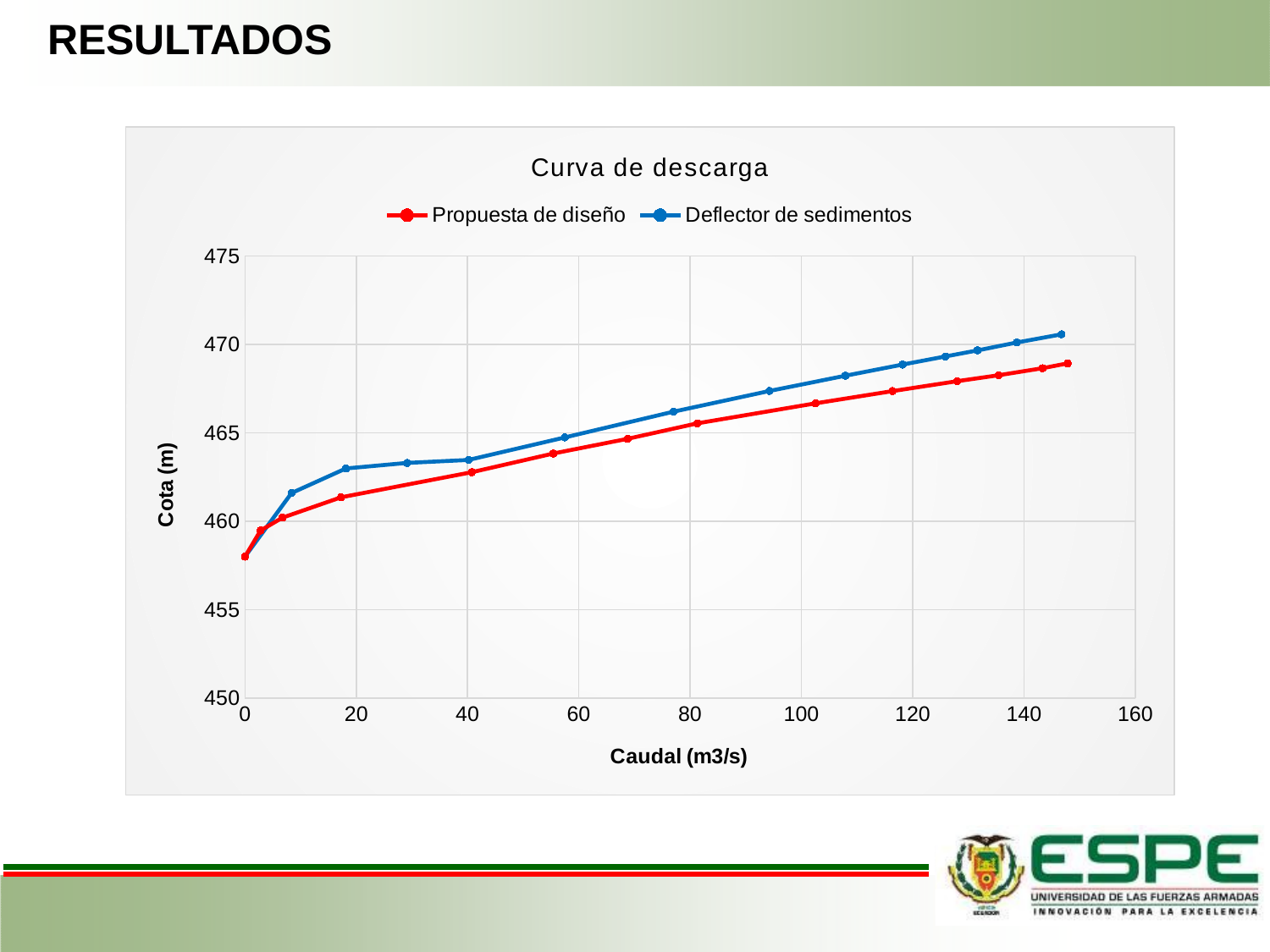
Is the value of the Deflector de sedimentos series at a Caudal of about 100 m3/s greater or less than 465? greater Do the values of the Deflector de sedimentos series rise or fall as Caudal increases? rise How many series does the legend list? 2 Do the values of the Propuesta de diseño series rise or fall as Caudal increases? rise Is the highest value of the Deflector de sedimentos series greater or less than 470? greater What kind of chart is shown on the slide? line chart Is the value of the Propuesta de diseño series at a Caudal of 0 greater or less than 460? less What is the title of the chart? Curva de descarga At a Caudal of about 40 m3/s, which series has the higher Cota: Propuesta de diseño or Deflector de sedimentos? Deflector de sedimentos What is the label of the y axis? Cota (m) At a Caudal of about 140 m3/s, which series has the lower Cota: Propuesta de diseño or Deflector de sedimentos? Propuesta de diseño